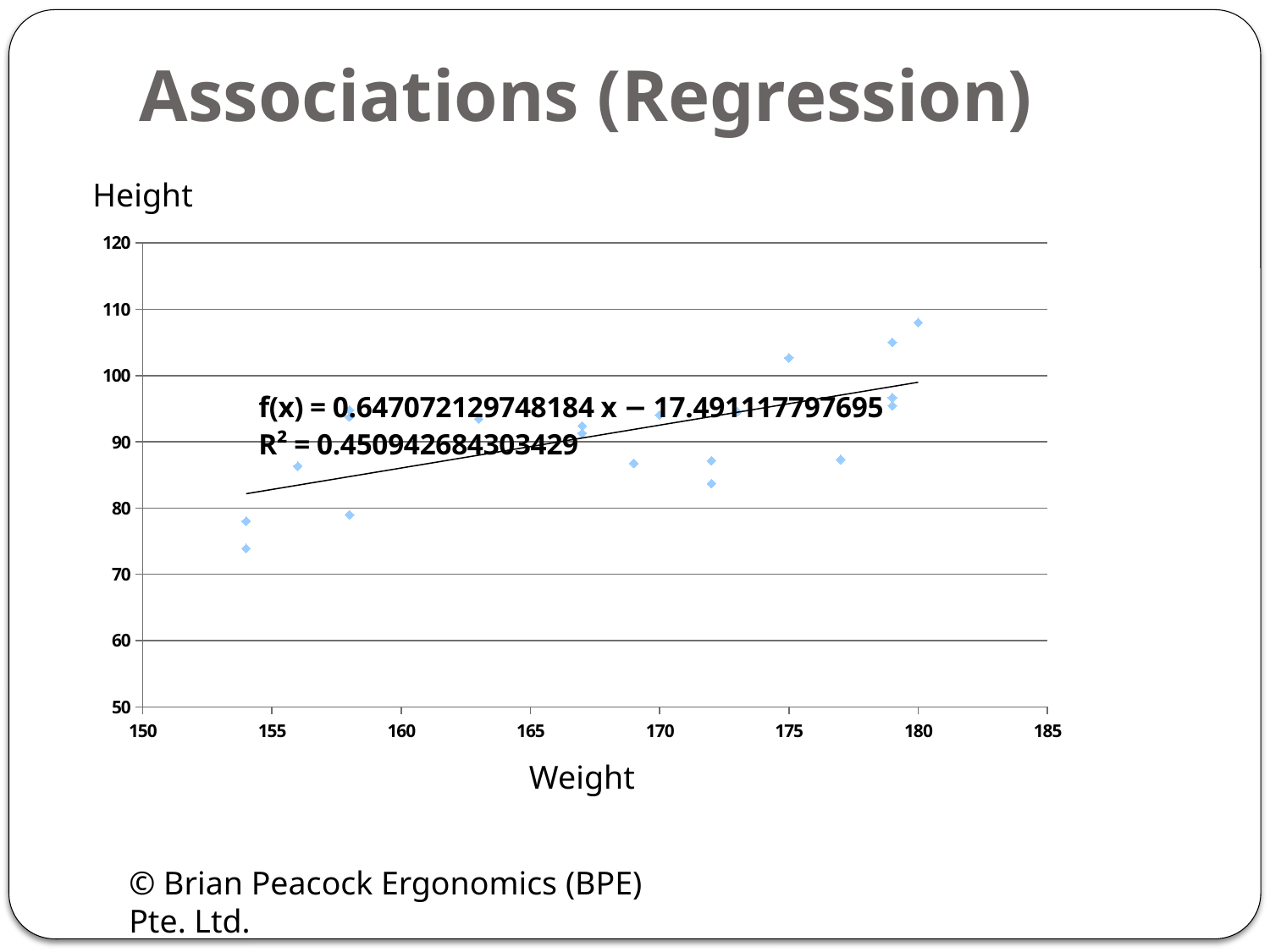
Is the height of the point at weight 180 greater or less than 100? greater Which has the greater height: the point at weight 175 or the point at weight 177? the point at weight 175 At which weight value is the highest height point plotted? 180 At which weight value is the lowest height point plotted? 154 Do the heights generally rise or fall as weight increases along the x axis? rise Is the height of the lowest point at weight 154 greater or less than 80? less What R² value is printed on the chart? 0.450942684303429 Which has the greater height: the point at weight 180 or the point at weight 169? the point at weight 180 What kind of chart is shown on the slide? scatter plot Is the height of the point at weight 175 greater or less than 100? greater What is the label of the x axis? Weight